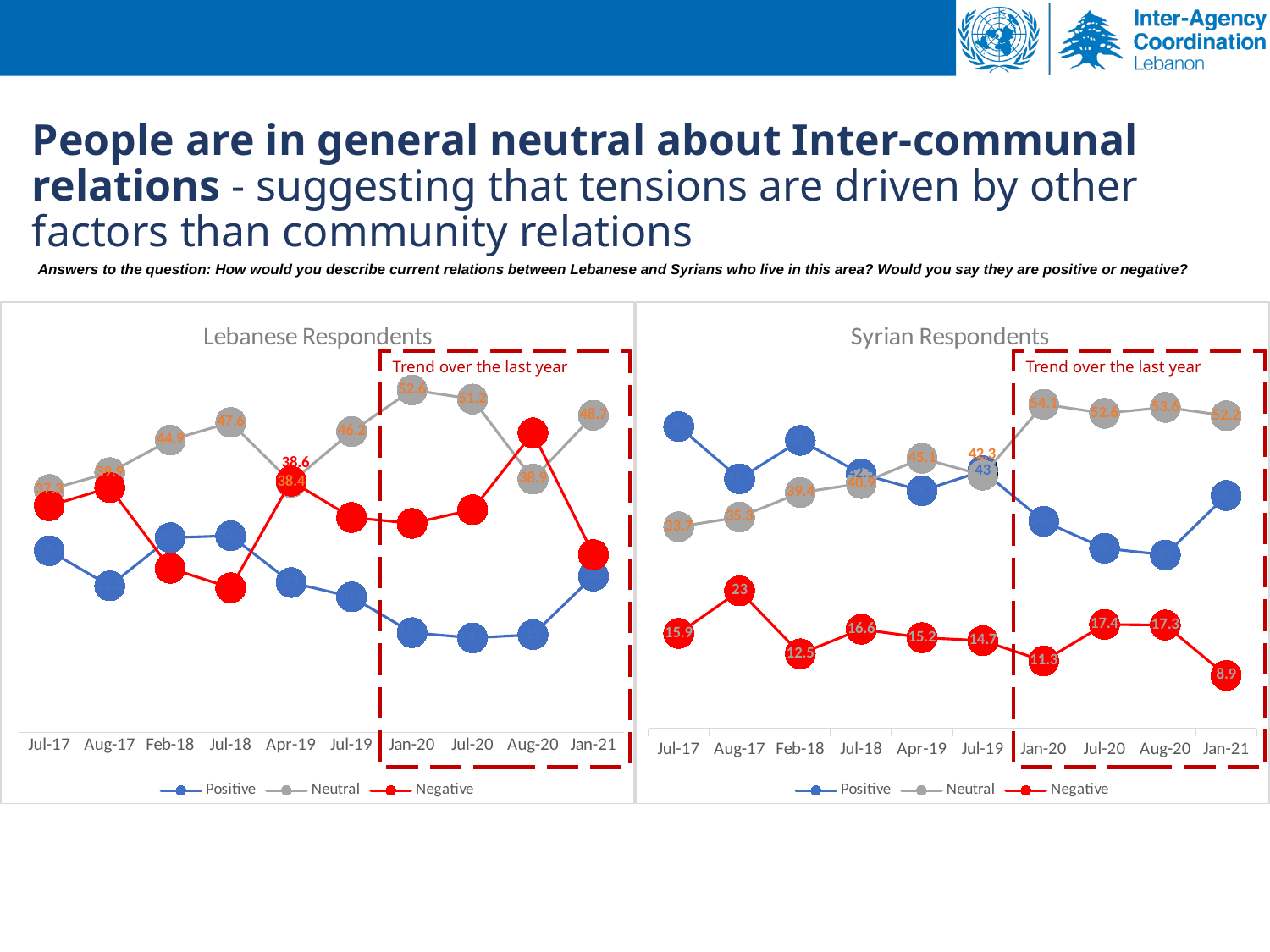
What kind of chart is the Lebanese Respondents chart? Line chart How many series does the legend of the Syrian Respondents chart list? 3 In the Syrian Respondents chart, at which time point is the Negative series lowest? Jan-21 In the Syrian Respondents chart, what is the Negative value for Jan-21? 8.9 In the Syrian Respondents chart, what is the Neutral value for Jan-20? 54.1 In the Syrian Respondents chart, does the Neutral series rise or fall overall from Jul-17 to Jan-21? Rise In the Syrian Respondents chart, at which time point is the Negative series highest? Aug-17 In the Syrian Respondents chart, what is the difference between the Negative value for Aug-17 and the Negative value for Jan-21? 14.1 How many time points are shown on the x axis of the Lebanese Respondents chart? 10 In the Syrian Respondents chart, what is the Negative value for Aug-17? 23 In the Lebanese Respondents chart, is the Neutral value higher in Jan-20 or in Aug-20? Jan-20 In the Lebanese Respondents chart, what is the Neutral value for Aug-20? 38.9